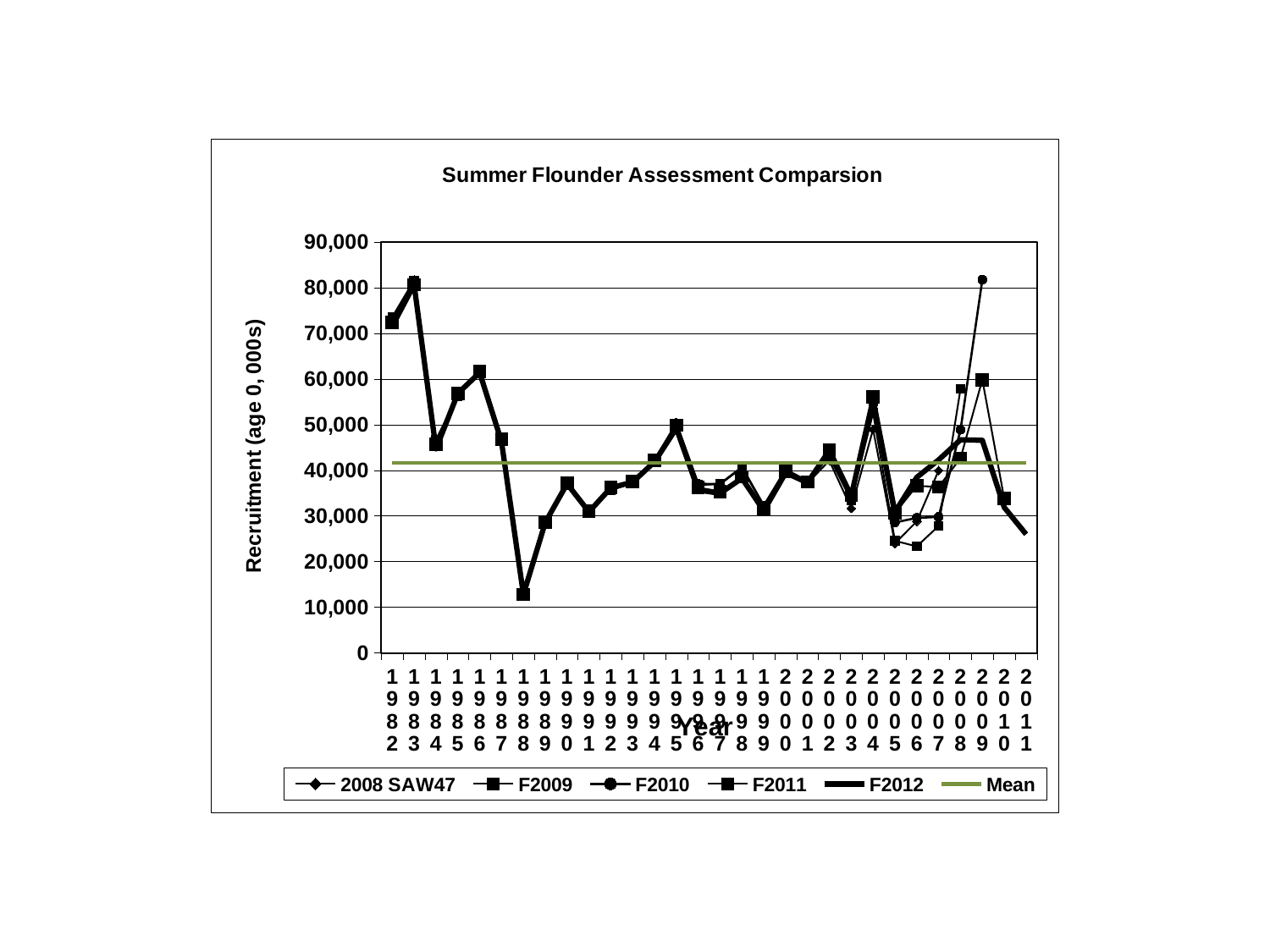
In which year does the F2012 line reach its lowest recruitment value? 1988 Is the recruitment value for 1983 greater or less than 70,000? greater How many years are shown along the x axis? 30 Do the recruitment values rise or fall from 1983 to 1988? fall How many series does the legend list? 6 Which year has the larger recruitment value, 2004 or 2005? 2004 What is the label of the y axis? Recruitment (age 0, 000s) Is the Mean line greater or less than 50,000? less Is the recruitment value for 1988 greater or less than 20,000? less What is the title of the chart? Summer Flounder Assessment Comparsion What kind of chart is shown on the slide? line chart Which year has the larger recruitment value, 1983 or 1988? 1983